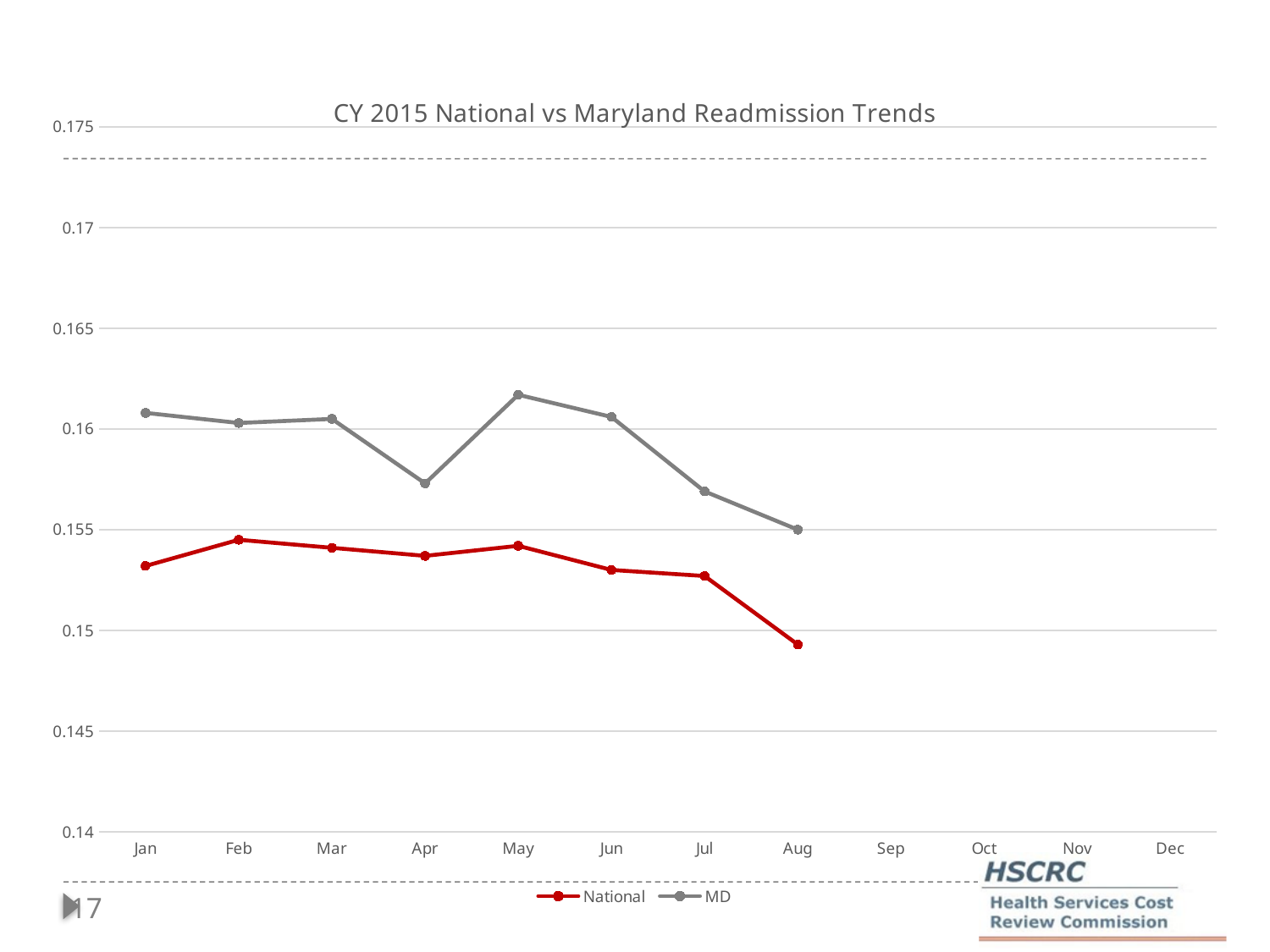
Is the value for MD in Apr greater or less than 0.155? greater In which month does the MD series reach its highest value? May What kind of chart is shown on the slide? line chart Is the value for National in Aug greater or less than 0.15? less In which month does the National series reach its lowest value? Aug Does the MD series rise or fall from May to Aug? fall Which series is drawn in red? National What is the title of the chart? CY 2015 National vs Maryland Readmission Trends How many series does the legend list? 2 How many months have plotted data points for the MD series? 8 In which month does the MD series reach its lowest value? Aug Which series has the larger value in Jan, National or MD? MD